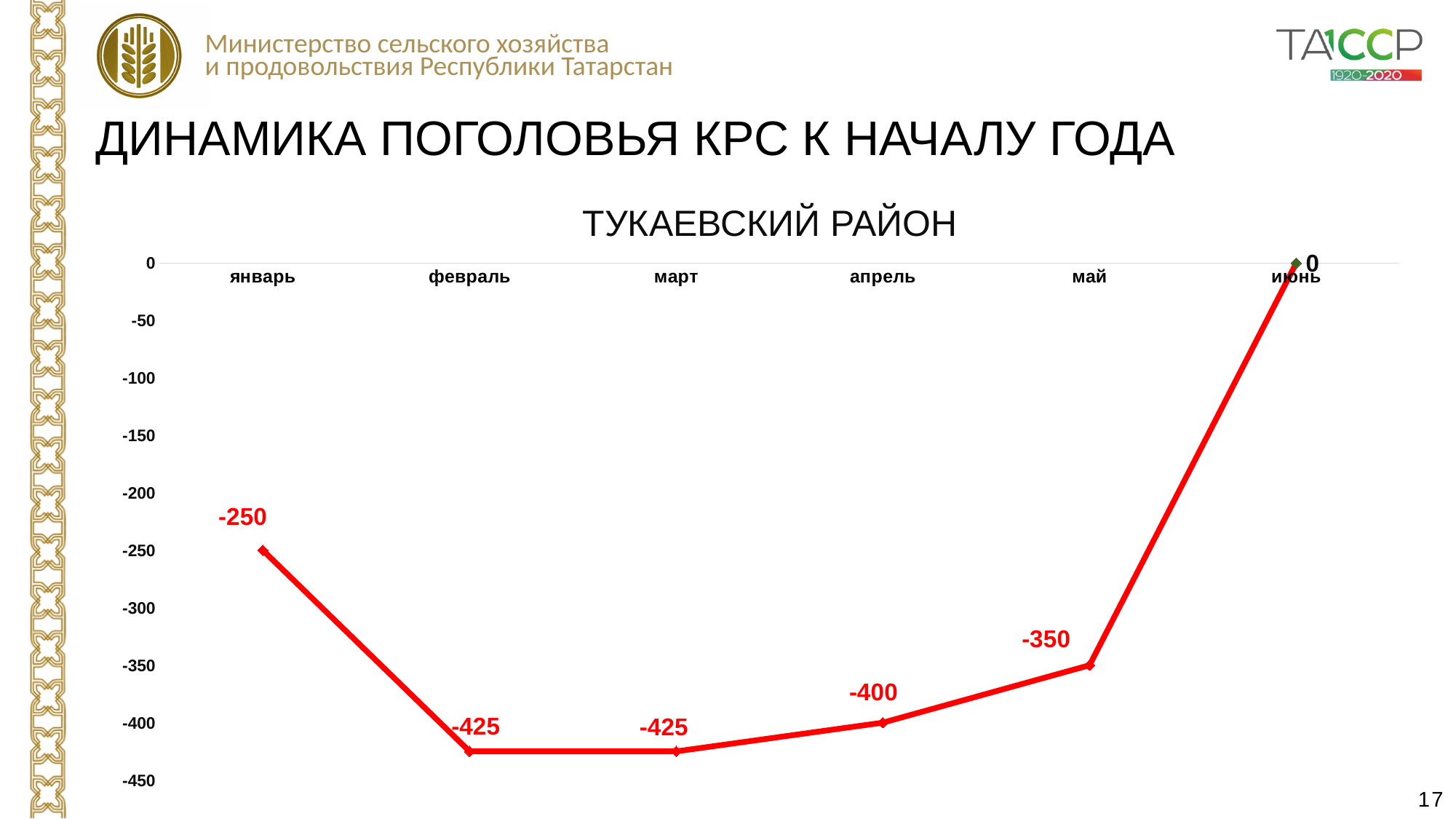
Is the value for январь greater or less than -300? greater Which is larger, the value for апрель or the value for март? апрель What is the value for апрель? -400 What kind of chart is shown on the slide? line chart What is the value for май? -350 Which month has the highest value? июнь What is the value for июнь? 0 What is the value for январь? -250 What is the title of the chart? ТУКАЕВСКИЙ РАЙОН How many months are plotted on the chart? 6 What is the difference between the values for январь and май? 100 What is the difference between the values for февраль and апрель? 25